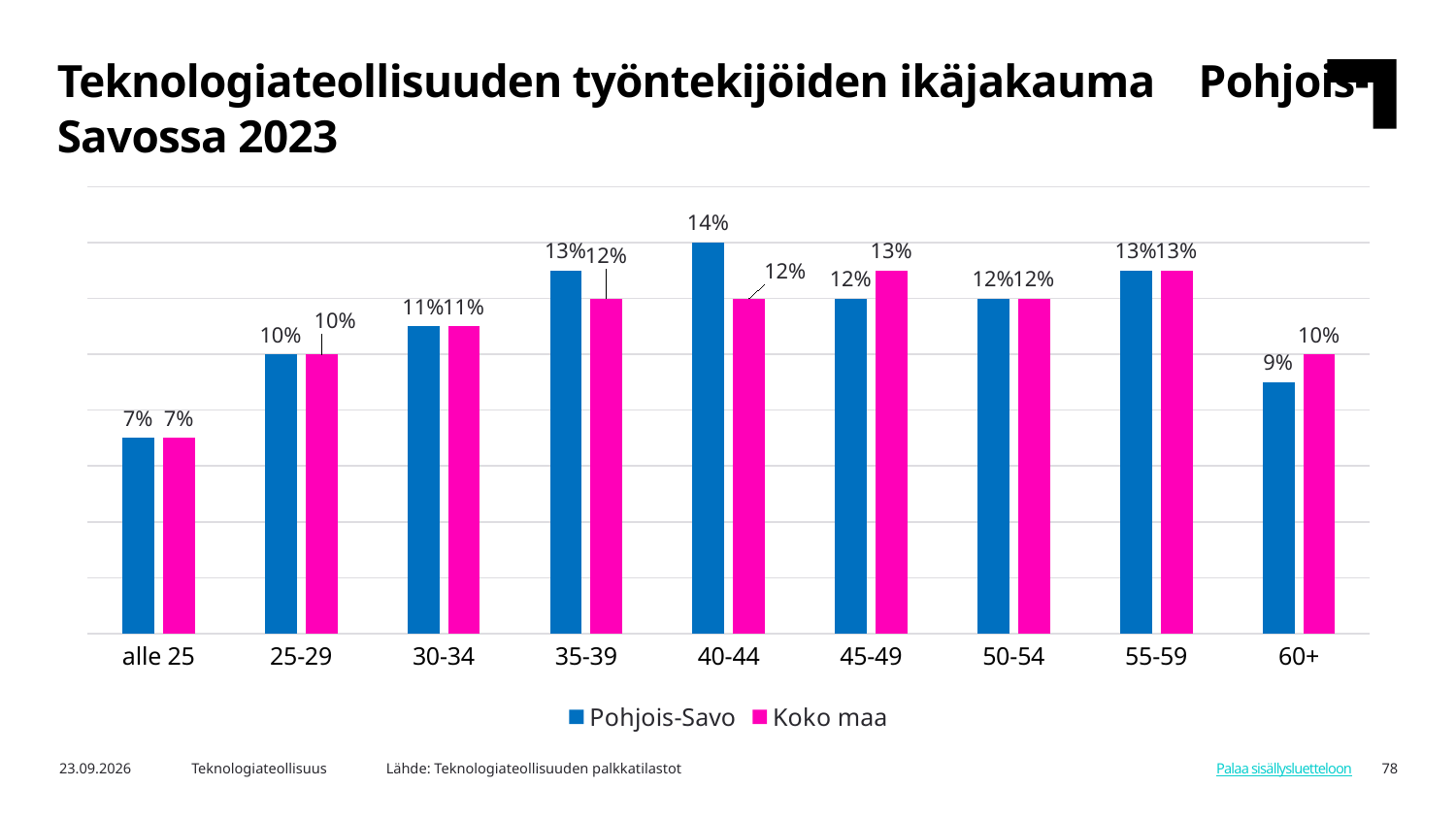
How many age groups are shown on the x axis? 9 What is the Koko maa value for the 60+ age group? 10% For the 60+ age group, which is larger: the Pohjois-Savo value or the Koko maa value? Koko maa What is the Pohjois-Savo value for the 35-39 age group? 13% What is the Koko maa value for the 45-49 age group? 13% Which series is shown in pink in the legend? Koko maa What kind of chart is shown on the slide? Bar chart Which age group has the highest Pohjois-Savo value? 40-44 What is the Pohjois-Savo value for the 40-44 age group? 14% How many series does the legend list? 2 What is the difference between the Pohjois-Savo and Koko maa values for the 40-44 age group? 2 percentage points Which age group has the lowest Koko maa value? alle 25